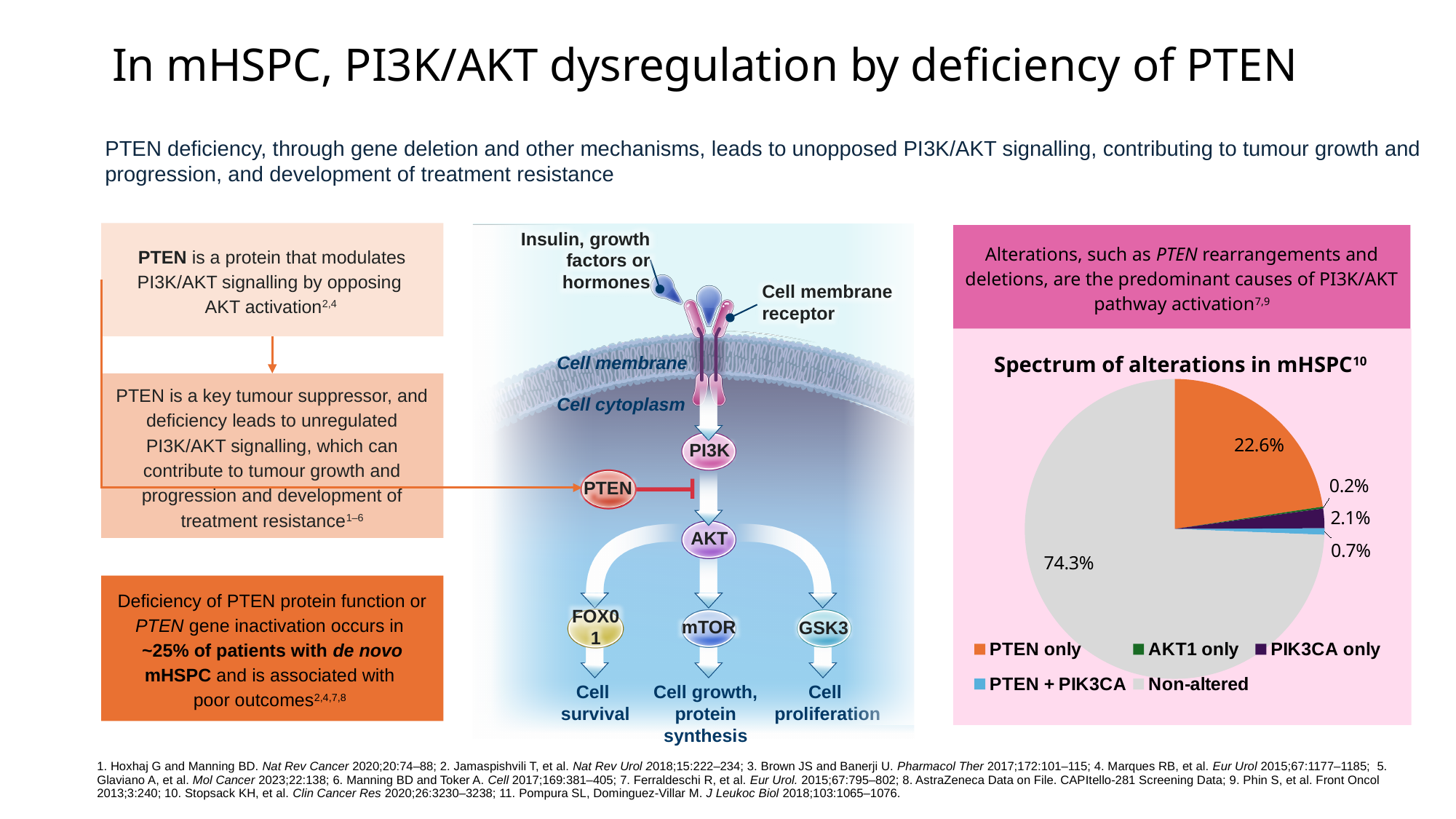
In the 'Spectrum of alterations in mHSPC' pie chart, what share is labelled for the AKT1 only slice? 0.2% In the 'Spectrum of alterations in mHSPC' pie chart, which slice is larger: PIK3CA only or PTEN + PIK3CA? PIK3CA only In the 'Spectrum of alterations in mHSPC' pie chart, which category has the smallest slice? AKT1 only In the 'Spectrum of alterations in mHSPC' pie chart, what share is labelled for the PTEN + PIK3CA slice? 0.7% In the 'Spectrum of alterations in mHSPC' pie chart, what share is labelled for the Non-altered slice? 74.3% What kind of chart is shown under the title 'Spectrum of alterations in mHSPC'? pie chart In the 'Spectrum of alterations in mHSPC' pie chart, what colour is the PTEN only slice? orange In the 'Spectrum of alterations in mHSPC' pie chart, what share is labelled for the PIK3CA only slice? 2.1% In the 'Spectrum of alterations in mHSPC' pie chart, which category has the largest slice? Non-altered In the 'Spectrum of alterations in mHSPC' pie chart, what is the difference in percentage points between the Non-altered and PTEN only slices? 51.7 How many categories does the legend of the 'Spectrum of alterations in mHSPC' pie chart list? 5 In the 'Spectrum of alterations in mHSPC' pie chart, what share is labelled for the PTEN only slice? 22.6%